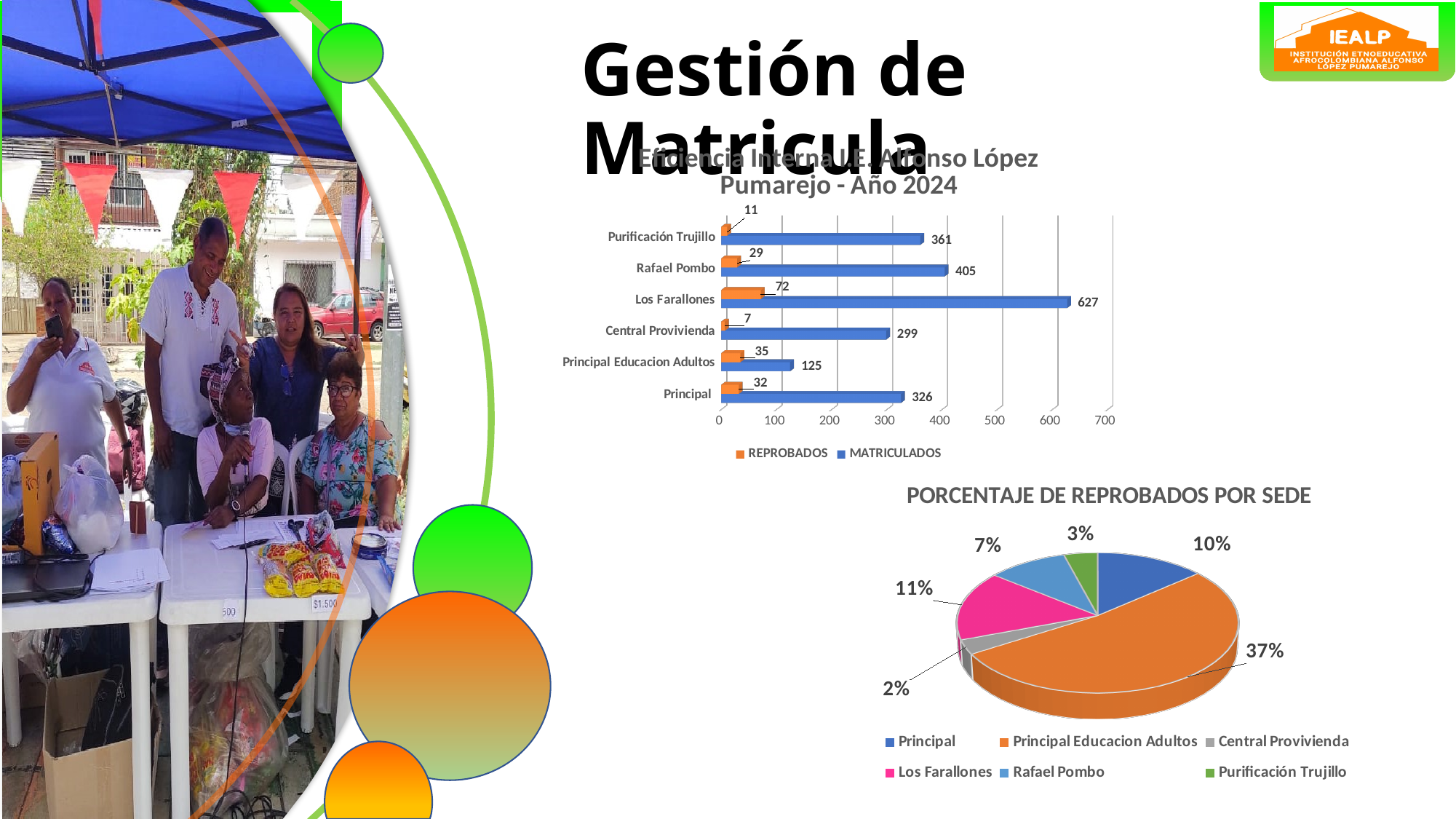
In the bar chart at the top right, which category has the lowest REPROBADOS value? Central Provivienda In the pie chart titled PORCENTAJE DE REPROBADOS POR SEDE, what share does Principal Educacion Adultos have? 37% In the bar chart at the top right, how many MATRICULADOS does Los Farallones have? 627 What kind of chart is the chart at the top right of the slide? Bar chart In the bar chart at the top right, how many categories are shown on the vertical axis? 6 In the pie chart titled PORCENTAJE DE REPROBADOS POR SEDE, what colour is the slice for Los Farallones? Pink In the bar chart at the top right, which has more REPROBADOS, Principal or Principal Educacion Adultos? Principal Educacion Adultos In the bar chart at the top right, what is the difference between the MATRICULADOS values of Rafael Pombo and Purificación Trujillo? 44 In the bar chart at the top right, which category has the highest MATRICULADOS value? Los Farallones In the bar chart at the top right, what is the REPROBADOS value for Central Provivienda? 7 In the bar chart at the top right, how many series does the legend list? 2 In the pie chart titled PORCENTAJE DE REPROBADOS POR SEDE, which sede has the smallest slice? Central Provivienda